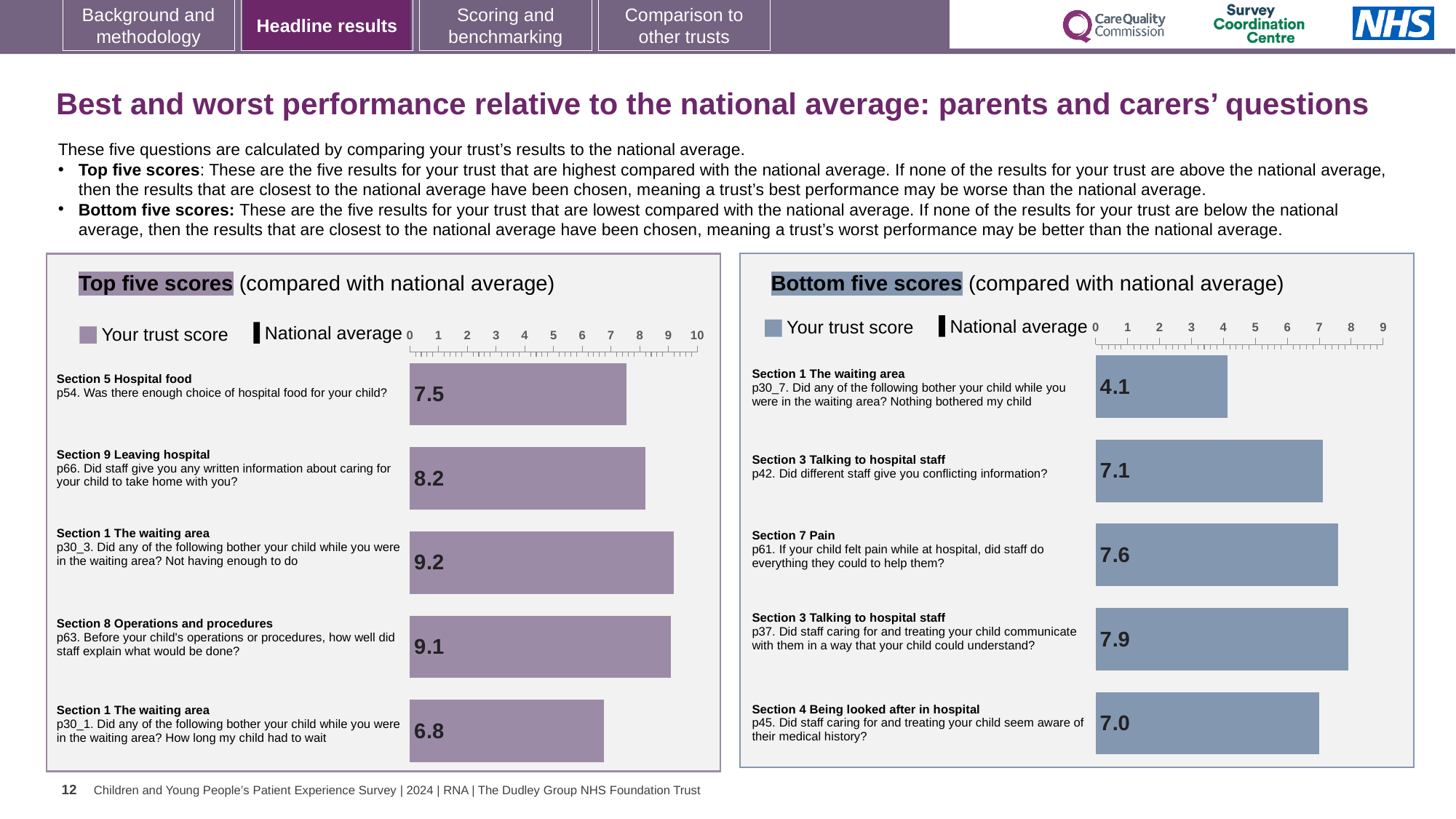
How many questions are plotted in the Bottom five scores chart? 5 In the Top five scores chart, which question has the highest trust score? p30_3 (Not having enough to do) In the Bottom five scores chart, what is the difference between the highest and lowest trust scores? 3.8 In the Top five scores chart, what is the trust score for p54 (Was there enough choice of hospital food for your child?)? 7.5 In the Top five scores chart, what is the difference between the trust scores for p66 and p54? 0.7 How many series does the legend of the Top five scores chart list? 2 In the Top five scores chart, which question has the lowest trust score? p30_1 (How long my child had to wait) What type of chart is the Top five scores chart? Bar chart In the Bottom five scores chart, is the trust score for p61 (Pain) greater or less than 7? greater In the Bottom five scores chart, which question has the highest trust score? p37 (Did staff communicate in a way your child could understand?) In the Top five scores chart, which has the larger trust score: p63 or p66? p63 In the Bottom five scores chart, what is the trust score for p30_7 (Nothing bothered my child in the waiting area)? 4.1